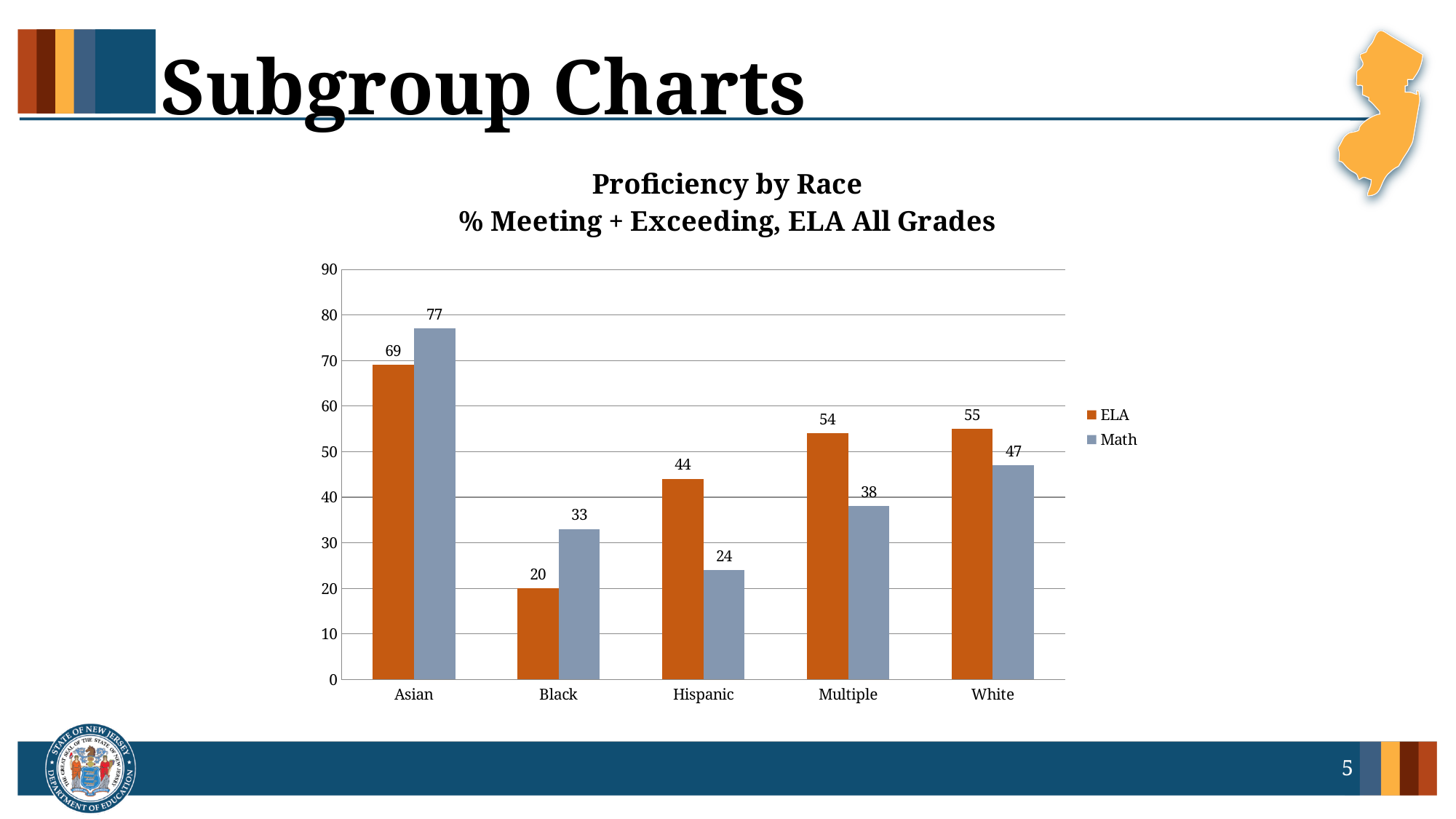
Is the ELA value for White greater or less than 50? greater What kind of chart is shown on the slide? Bar chart What is the difference between the Math and ELA values for Asian? 8 What is the Math value for Hispanic? 24 What is the ELA value for Asian? 69 Which category has the highest Math value? Asian What is the title of the chart? Proficiency by Race % Meeting + Exceeding, ELA All Grades How many categories are shown on the x axis? 5 Which is larger for Hispanic, the ELA value or the Math value? ELA What is the Math value for Black? 33 Which category has the lowest ELA value? Black How many series does the legend list? 2